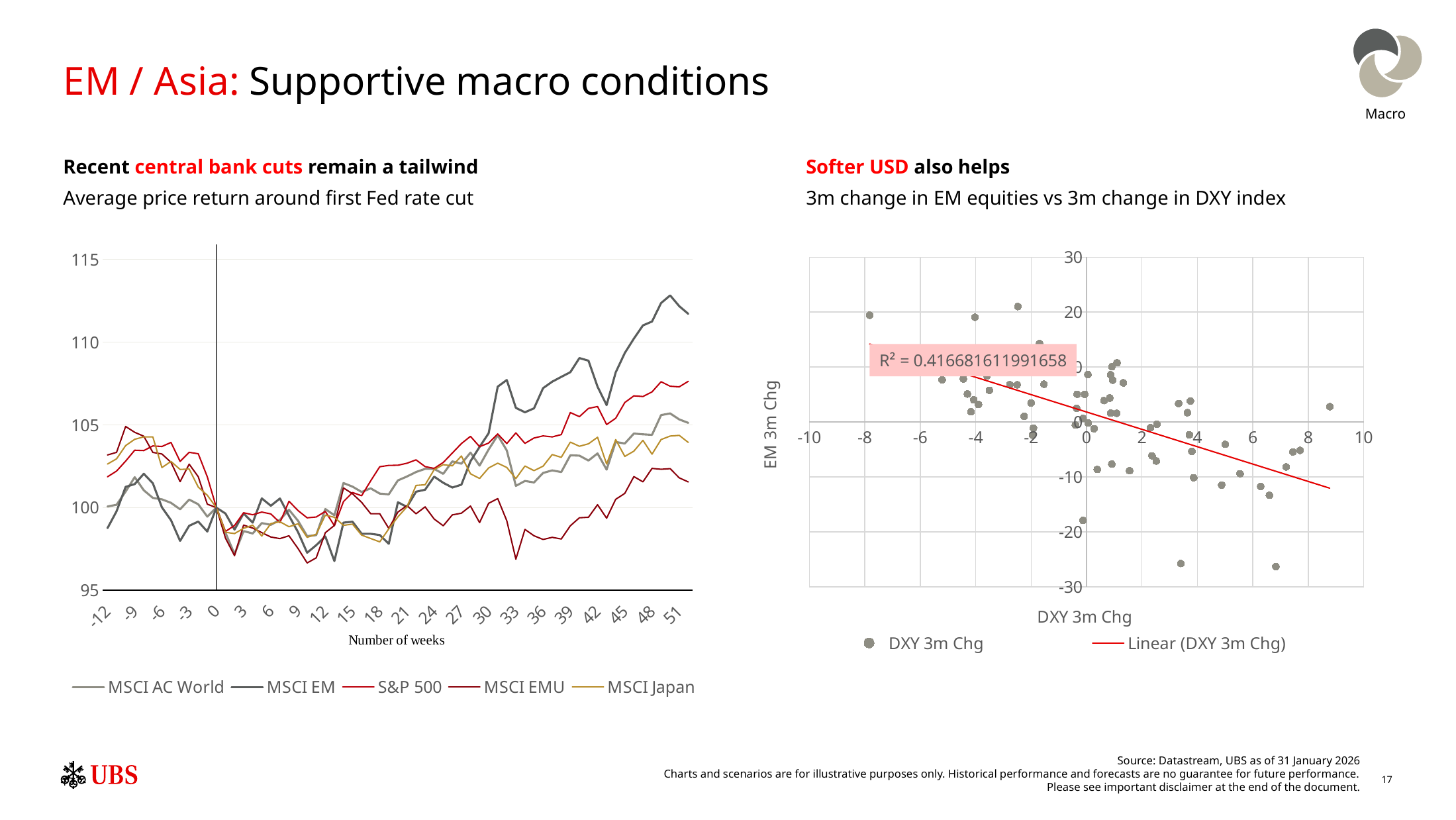
In the left chart, does the MSCI EM line rise or fall between week 0 and week 51? rise In the left chart, is the value for MSCI EM at week 51 greater or less than 110? greater What kind of chart is the right chart, '3m change in EM equities vs 3m change in DXY index'? Scatter chart In the left chart, which series is lowest at week 51? MSCI EMU In the left chart, is the value for MSCI EMU at week 33 greater or less than 100? less What kind of chart is the left chart, 'Average price return around first Fed rate cut'? Line chart In the right chart, does the linear trend line rise or fall as DXY 3m Chg increases? fall In the left chart, which series is highest at week 51? MSCI EM How many series does the legend of the left chart list? 5 How many entries does the legend of the right chart list? 2 In the right chart, what R² value is shown? R² = 0.416681611991658 In the left chart, what is the x-axis title? Number of weeks